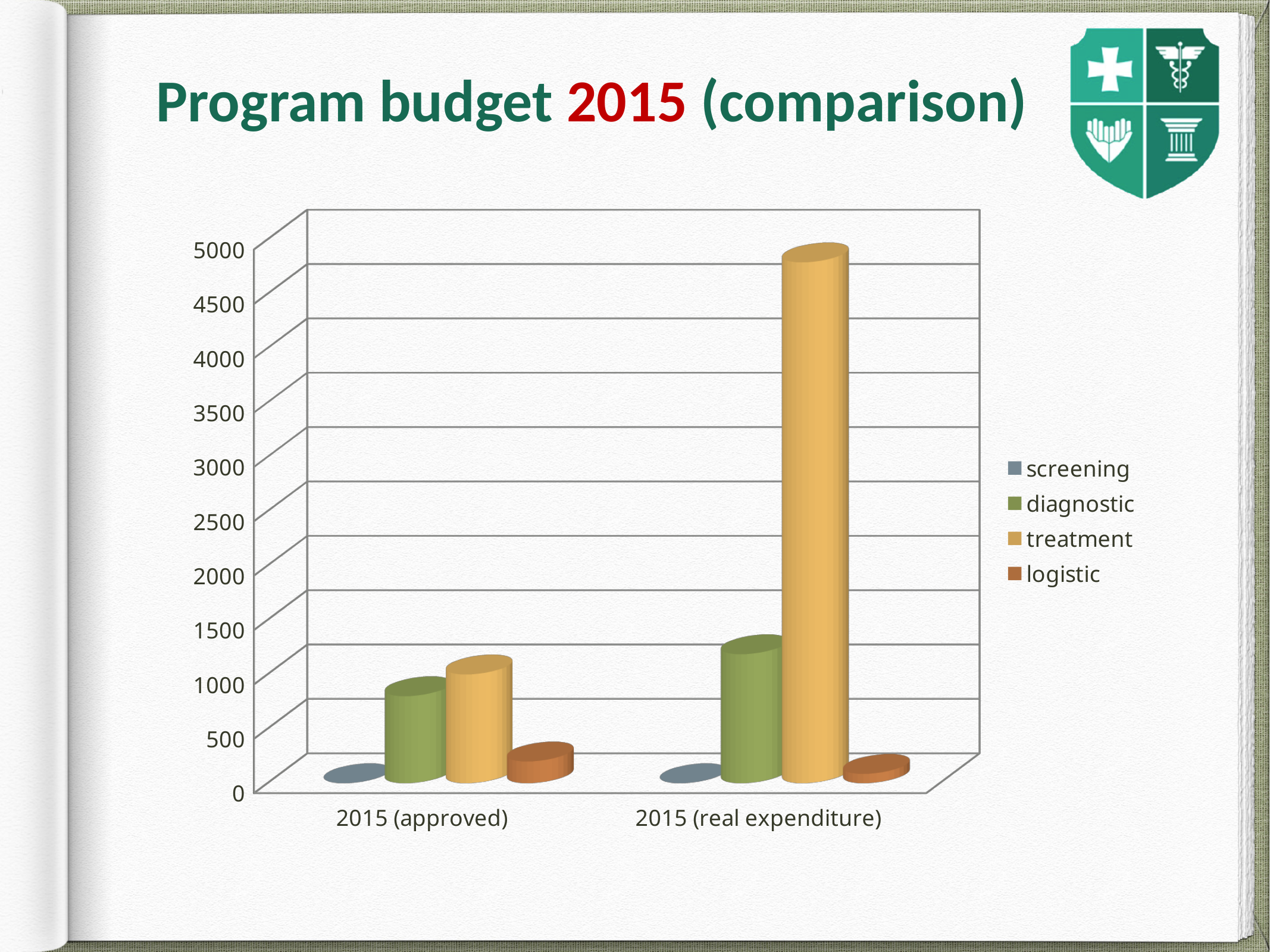
How many categories are shown on the x axis? 2 What kind of chart is shown on the slide? bar chart Which series has the lowest value for 2015 (approved)? screening Is the value for treatment in 2015 (real expenditure) greater or less than 4000? greater How many series does the legend list? 4 Is the value for diagnostic in 2015 (real expenditure) greater or less than 500? greater Is the value for logistic in 2015 (real expenditure) greater or less than 500? less Which series is shown in yellow in the legend? treatment Which is larger: treatment in 2015 (approved) or treatment in 2015 (real expenditure)? 2015 (real expenditure) What is the title of the slide containing the chart? Program budget 2015 (comparison) Which series has the highest value for 2015 (real expenditure)? treatment